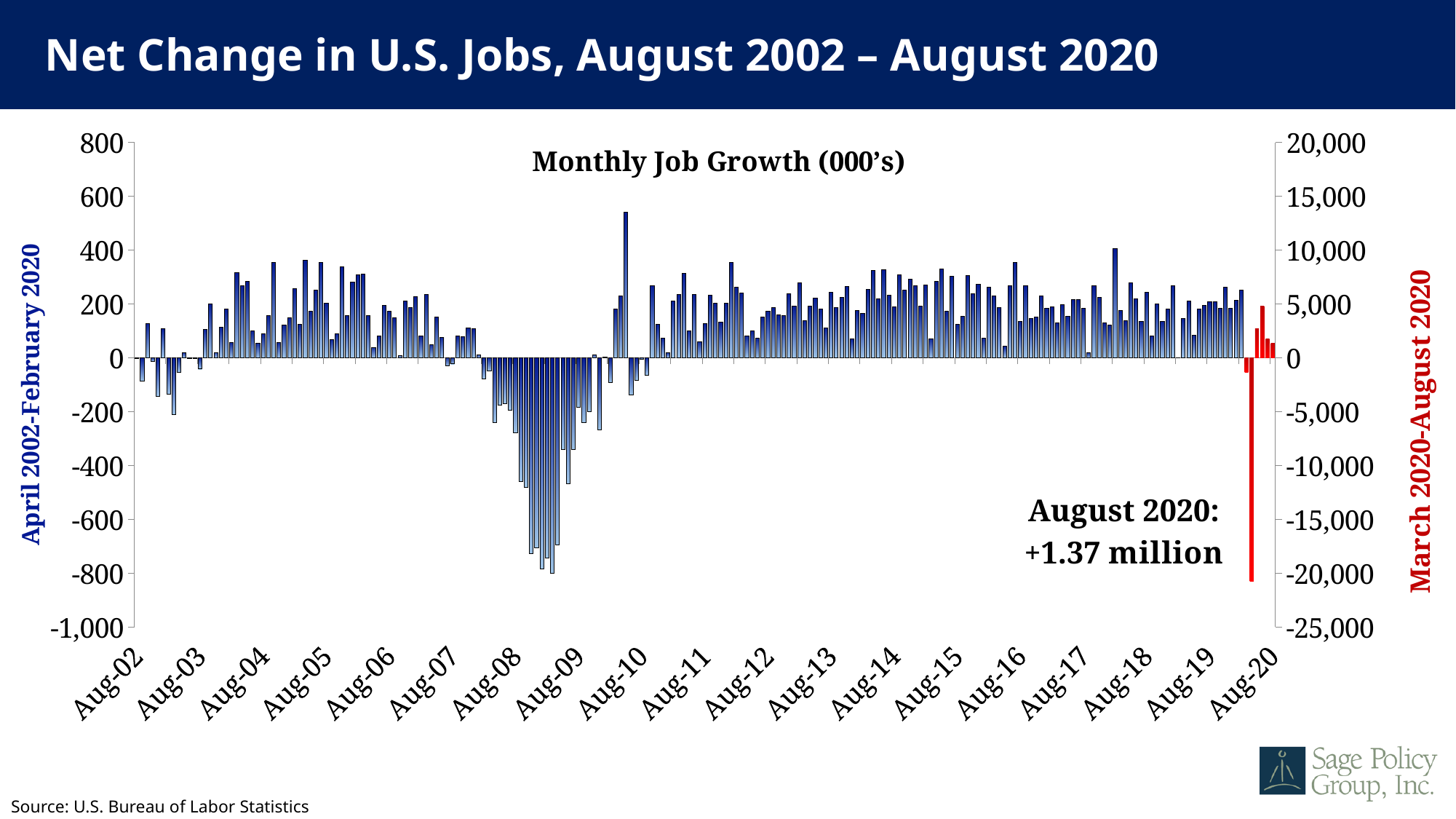
What colour are the bars for the March 2020-August 2020 period? red What is the lowest value shown on the right vertical axis? -25,000 According to the annotation on the chart, what was the net change in U.S. jobs in August 2020? +1.37 million How many red bars (March 2020-August 2020) are plotted on the chart? 6 Is the lowest red bar (April 2020) greater or less than -15,000 on the right axis? less Is the value for Aug-08 greater or less than 0? less Is the lowest blue bar (around early 2009) greater or less than -600 on the left axis? less What kind of chart is shown on the slide? bar chart What is the highest value shown on the left vertical axis? 800 What is the title printed inside the chart area? Monthly Job Growth (000's) Which is larger, the value for Aug-05 or the value for Aug-08? Aug-05